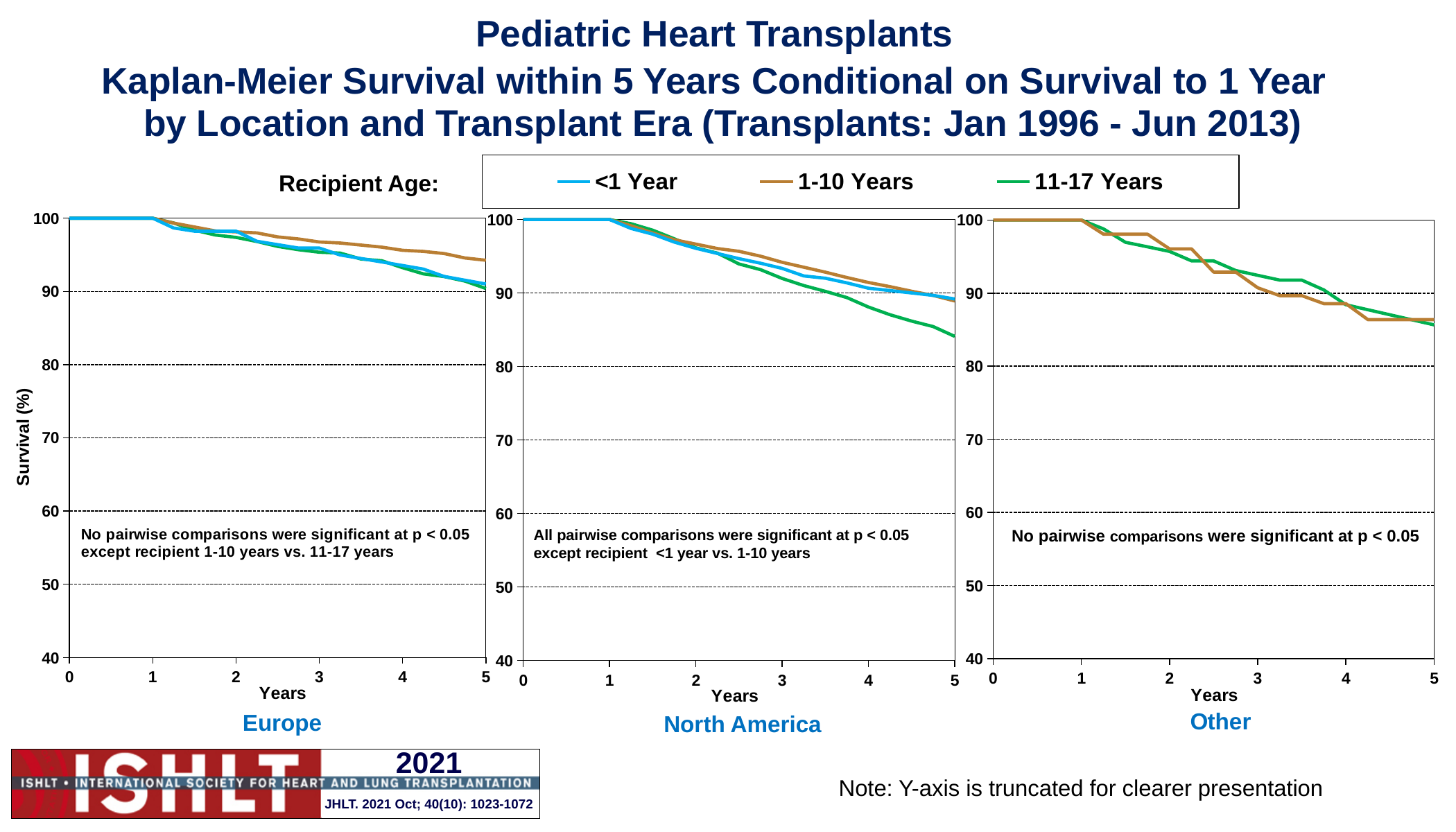
In the Europe chart, is the value for 1-10 Years at 5 years greater or less than 90? greater In the Europe chart, does survival for the 1-10 Years series rise or fall as years increase? fall How many series does the legend list? 3 In the North America chart, which series has the higher survival at 5 years, <1 Year or 11-17 Years? <1 Year What kind of chart is the Europe chart? line chart In the North America chart, is the value for 11-17 Years at 5 years greater or less than 90? less In the Other chart, is the value for 11-17 Years at 2 years greater or less than 90? greater In the Europe chart, which series has the higher survival at 5 years, 1-10 Years or 11-17 Years? 1-10 Years How many charts are shown on the slide? 3 What is the label of the y-axis on the Europe chart? Survival (%) Which chart states that all pairwise comparisons were significant at p < 0.05 except recipient <1 year vs. 1-10 years? North America